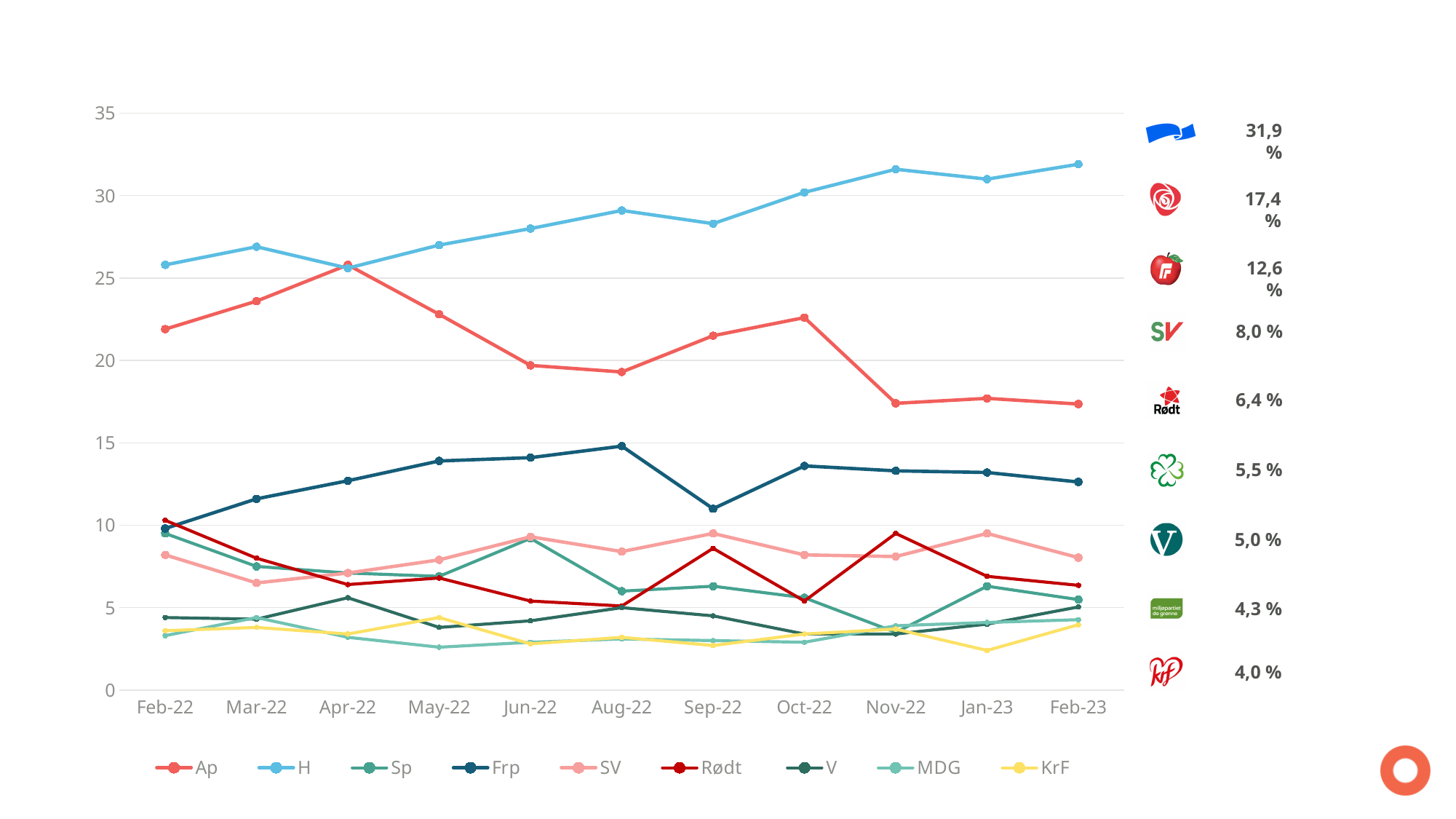
Does the H line rise or fall from Feb-22 to Feb-23? rise What kind of chart is shown on the slide? line chart What percentage is printed beside the SV logo on the right of the chart? 8,0 % How many series does the legend list? 9 Which is larger at Aug-22, Frp or SV? Frp Which series has the lowest value at Jan-23? KrF What percentage is printed beside the Rødt logo on the right of the chart? 6,4 % Is the value for Frp at Sep-22 greater or less than 15? less Which series has the highest value at Feb-23? H How many time points are shown along the x axis? 11 Is the value for H at Feb-23 greater or less than 30? greater Is the value for Ap at Nov-22 greater or less than 20? less